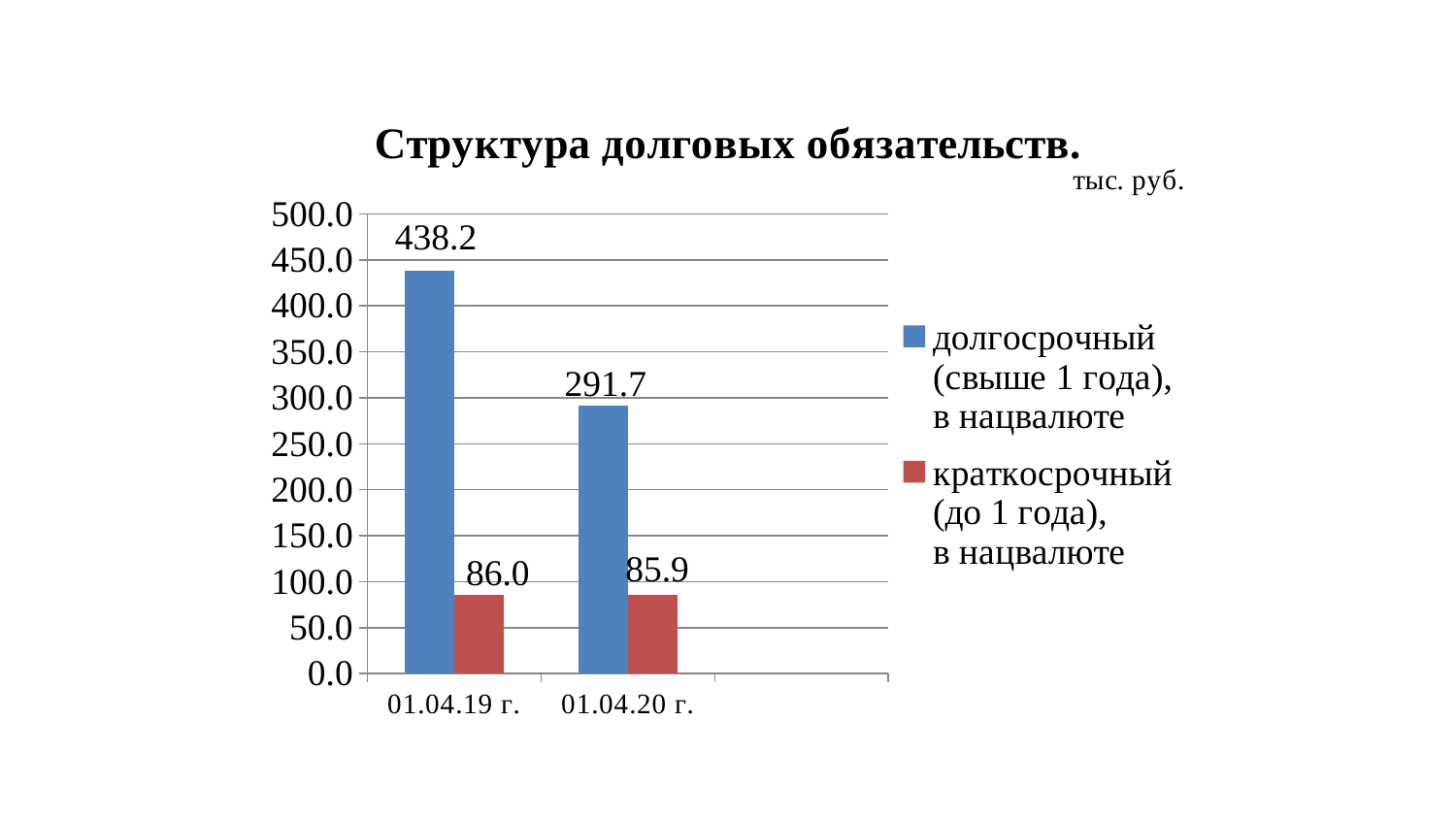
How many series does the legend list? 2 What is the value of the short-term (краткосрочный) series for 01.04.19 г.? 86.0 What is the value of the long-term (долгосрочный) series for 01.04.19 г.? 438.2 What is the difference between the long-term values for 01.04.19 г. and 01.04.20 г.? 146.5 For 01.04.19 г., which is larger: the long-term or the short-term value? long-term (долгосрочный) What is the value of the short-term (краткосрочный) series for 01.04.20 г.? 85.9 What is the difference between the long-term and short-term values for 01.04.20 г.? 205.8 What kind of chart is shown on the slide? bar chart Does the long-term (долгосрочный) value rise or fall from 01.04.19 г. to 01.04.20 г.? fall Which date has the higher long-term (долгосрочный) value? 01.04.19 г. How many dates (categories) are shown on the x axis? 2 What is the value of the long-term (долгосрочный) series for 01.04.20 г.? 291.7